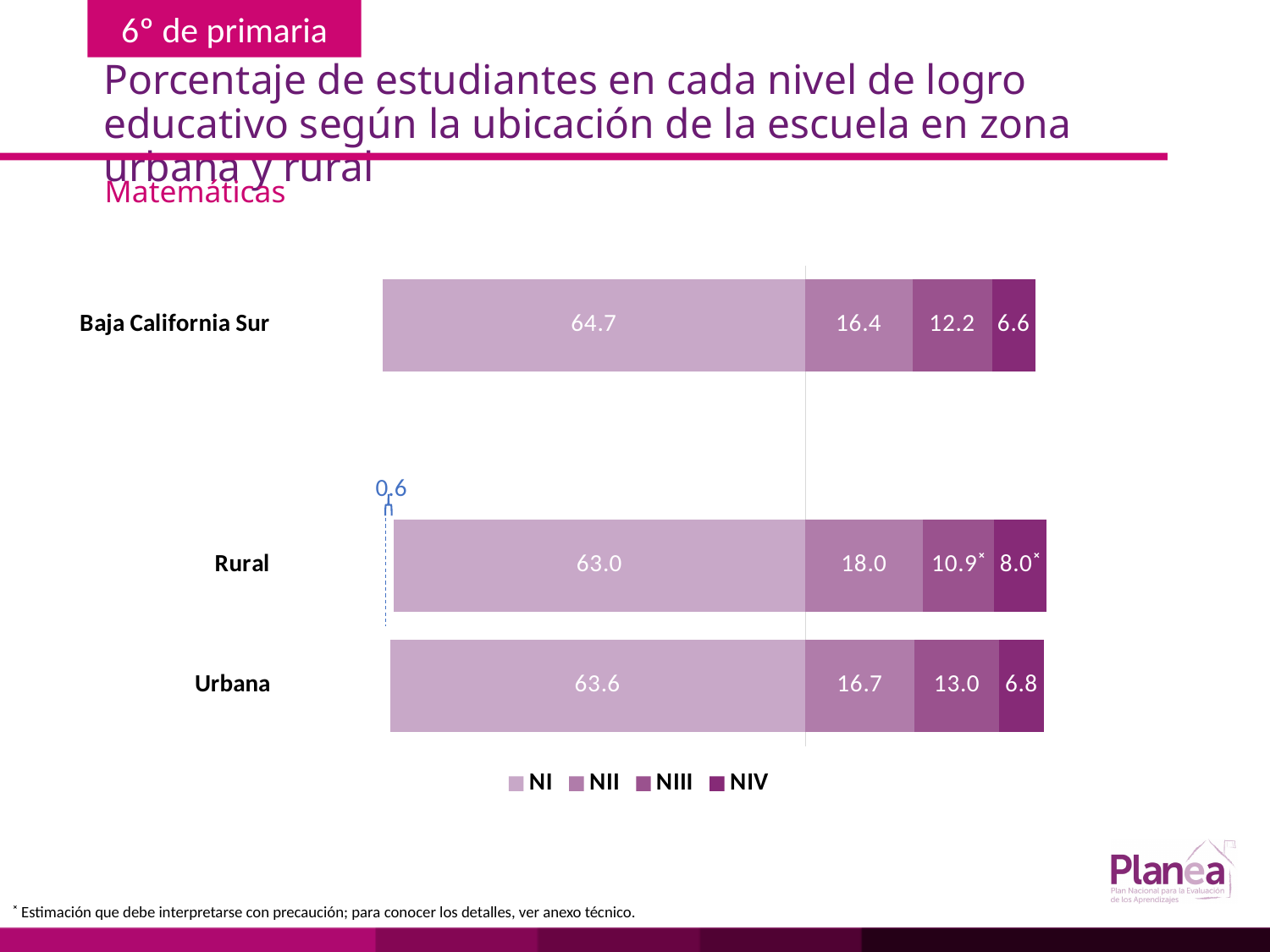
What kind of chart is shown on the slide? Stacked bar chart Which category has the highest NII value? Rural What is the NIV value for Rural? 8.0 How many categories are plotted on the chart? 3 Which category has the lowest NIII value? Rural What is the difference between the NI values for Baja California Sur and Urbana? 1.1 What is the total of the stacked bar for Baja California Sur? 99.9 What is the NII value for Rural? 18.0 What is the NI value for Baja California Sur? 64.7 Which is larger, the NIV value for Urbana or the NIV value for Baja California Sur? Urbana What is the NIII value for Urbana? 13.0 How many series does the legend list? 4